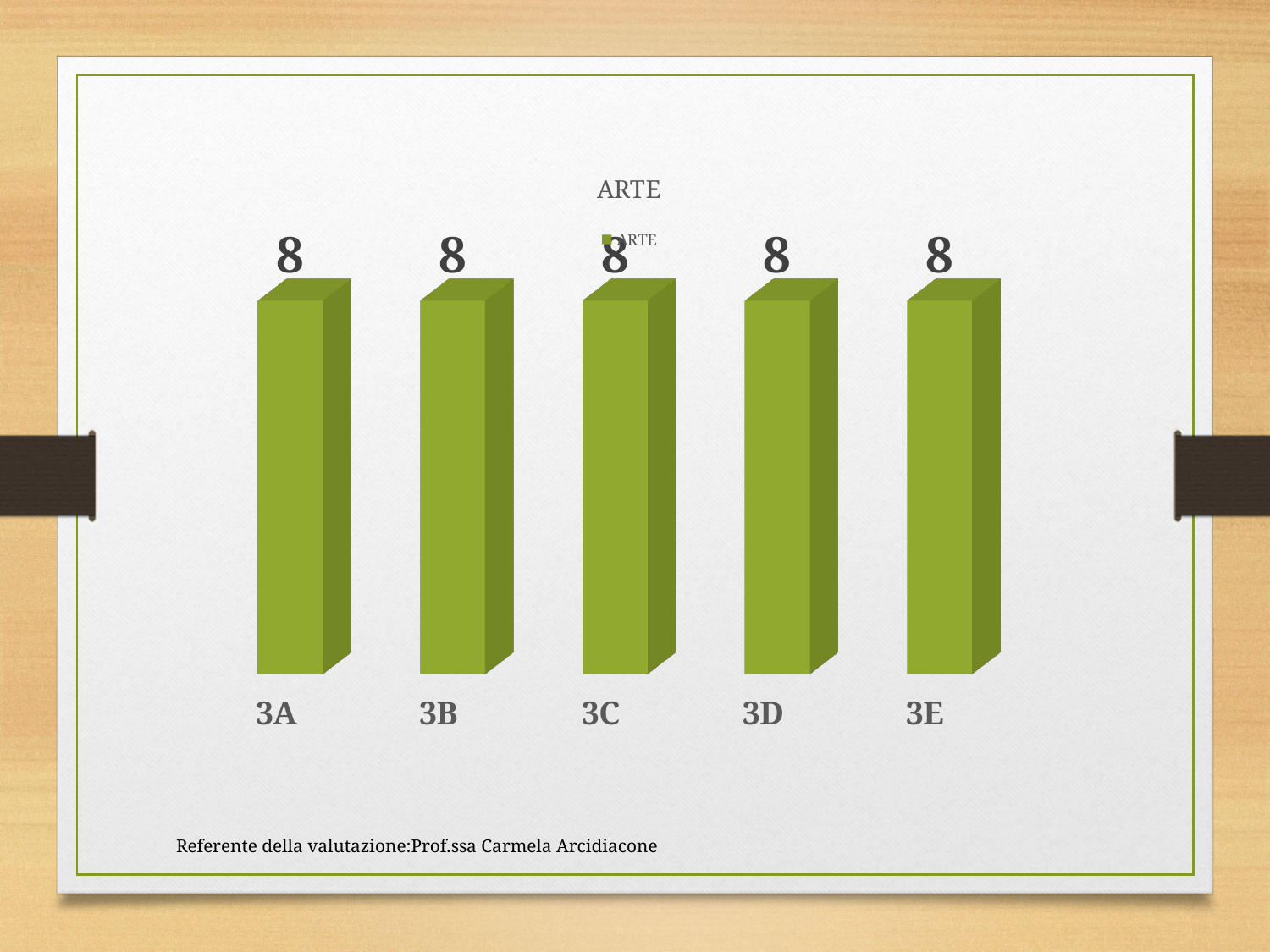
What is the name of the series listed in the legend? ARTE What is the title of the chart? ARTE How many categories are shown on the x axis? 5 What kind of chart is shown? bar chart What is the value for 3C? 8 What is the value for 3A? 8 What is the value for 3E? 8 How many series does the legend list? 1 What is the value for 3D? 8 What is the difference between the values for 3B and 3D? 0 Do the values rise, fall or stay the same from 3A to 3E? stay the same